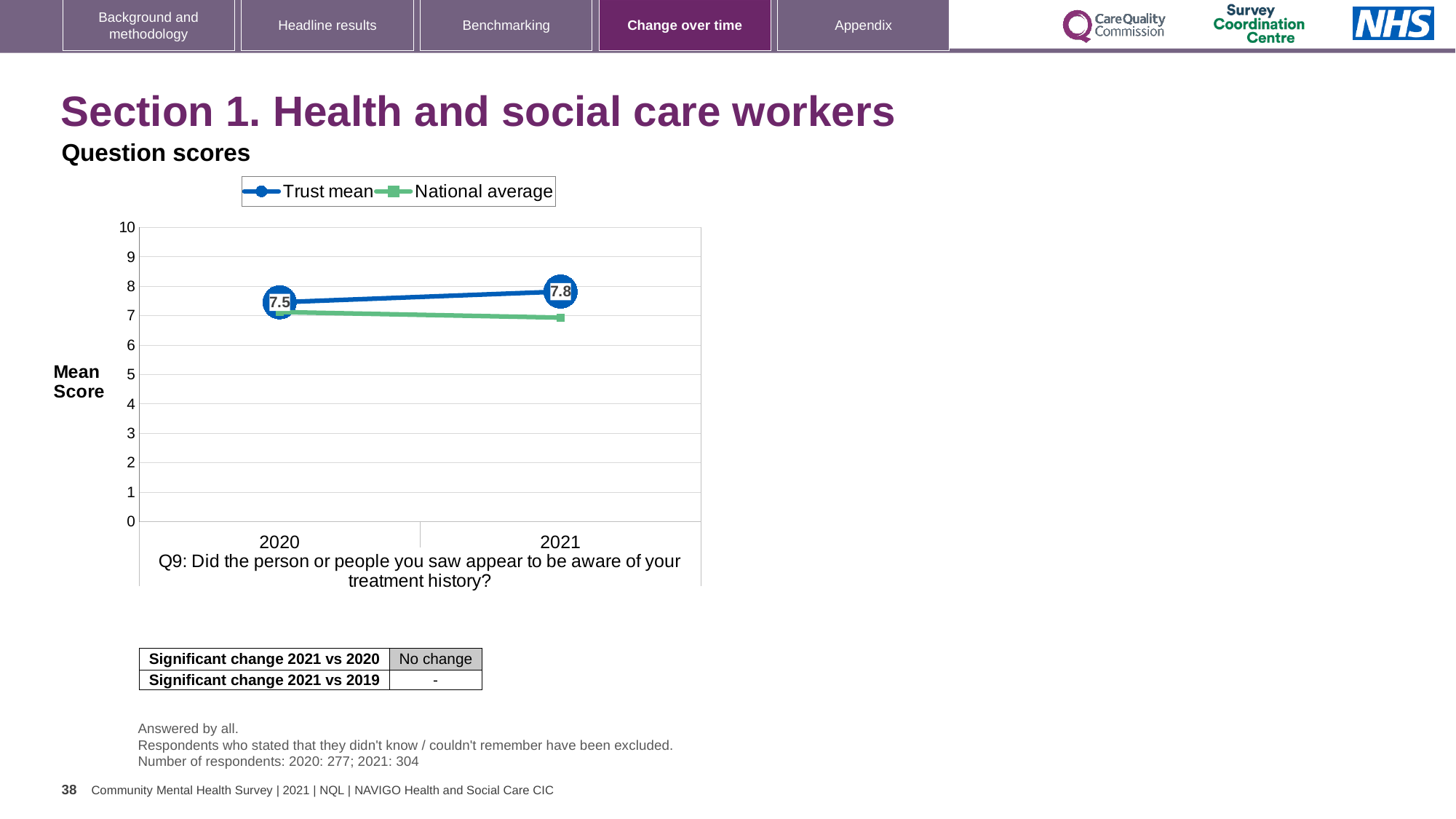
In 2021, which is higher: the Trust mean or the National average? Trust mean How many series does the legend list? 2 What is the Trust mean score for 2020? 7.5 What is the Trust mean score for 2021? 7.8 Does the Trust mean rise or fall from 2020 to 2021? Rise Is the National average value for 2021 greater or less than 8? less In which year is the Trust mean score lowest? 2020 In which year is the Trust mean score highest? 2021 What kind of chart is shown on the slide? Line chart What is the difference between the Trust mean scores for 2021 and 2020? 0.3 How many years are plotted on the x axis? 2 Is the National average value for 2020 greater or less than 6? greater